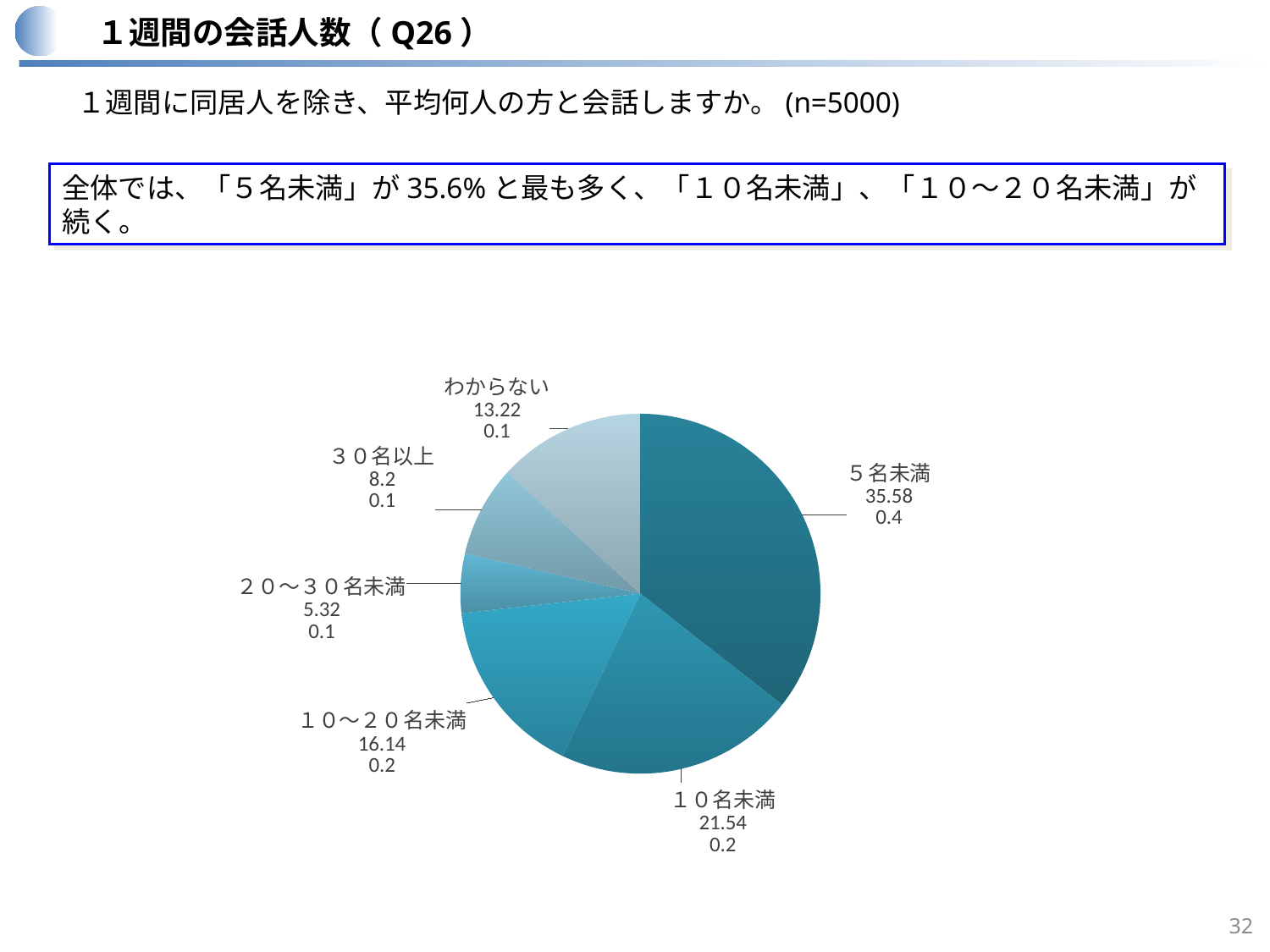
How many categories (slices) does the pie chart have? 6 What kind of chart is shown on the slide? pie chart What is the value shown for the わからない slice? 13.22 Which category has the smallest slice of the pie? 20～30名未満 What is the difference between the values for 5名未満 and 10名未満? 14.04 What is the value shown for the 10名未満 slice? 21.54 Which category has the largest slice of the pie? 5名未満 What is the title of the slide containing the chart? １週間の会話人数（Q26） What is the value shown for the 30名以上 slice? 8.2 What is the difference between the values for 10～20名未満 and わからない? 2.92 What is the value shown for the 5名未満 slice? 35.58 Which is larger, the value for 30名以上 or the value for 20～30名未満? 30名以上